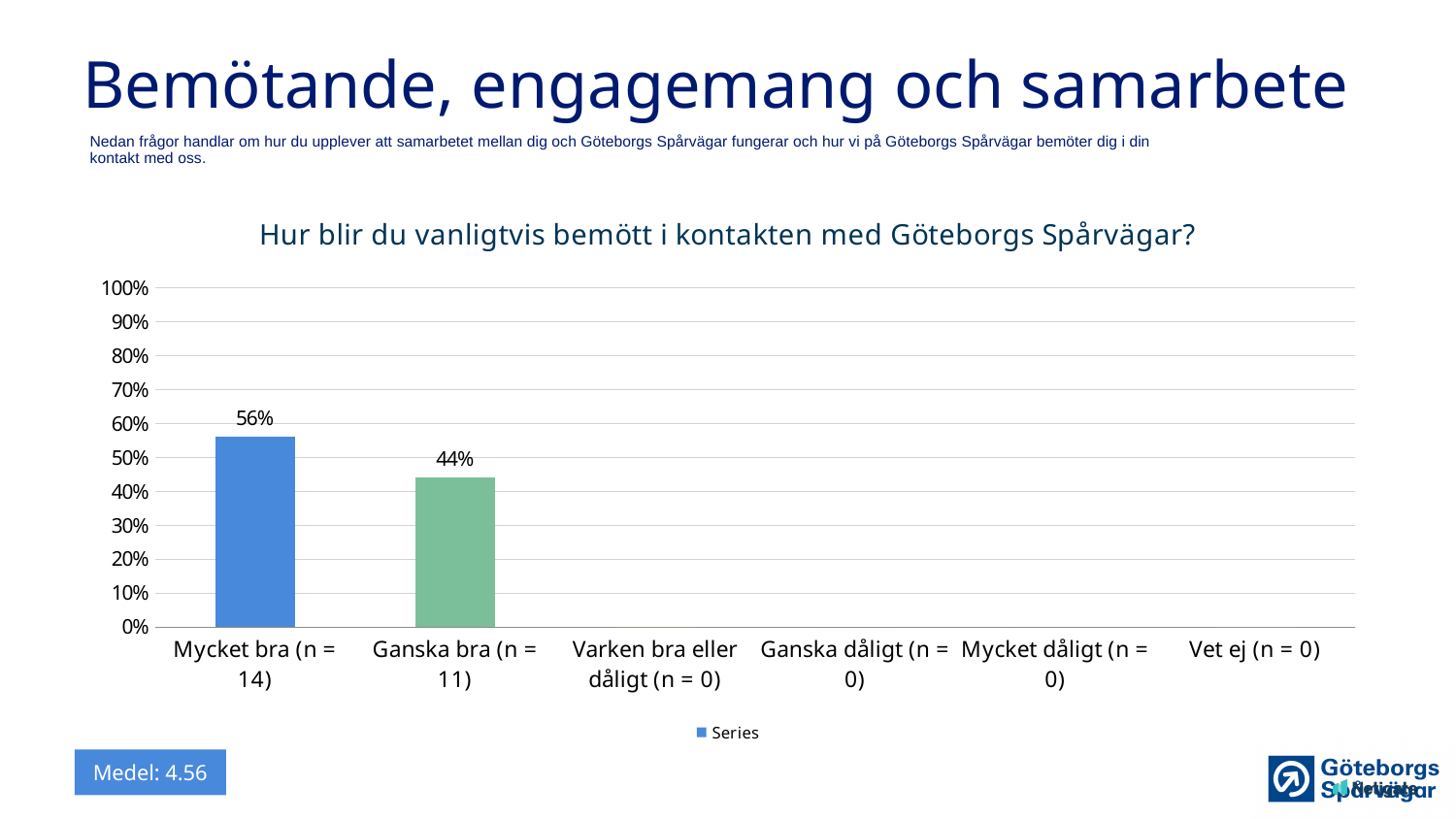
How many categories are shown on the x axis? 6 Which is larger, the value for "Mycket bra (n = 14)" or "Ganska bra (n = 11)"? Mycket bra (n = 14) Which category has the highest value? Mycket bra (n = 14) What kind of chart is shown? bar chart Is the value for "Mycket bra (n = 14)" greater or less than 50%? greater How many series does the legend list? 1 What is the maximum value shown on the y axis? 100% Is the value for "Ganska bra (n = 11)" greater or less than 50%? less What is the value for "Mycket bra (n = 14)"? 56% What is the difference between the values for "Mycket bra (n = 14)" and "Ganska bra (n = 11)"? 12% What is the title of the chart? Hur blir du vanligtvis bemött i kontakten med Göteborgs Spårvägar? What is the value for "Ganska bra (n = 11)"? 44%